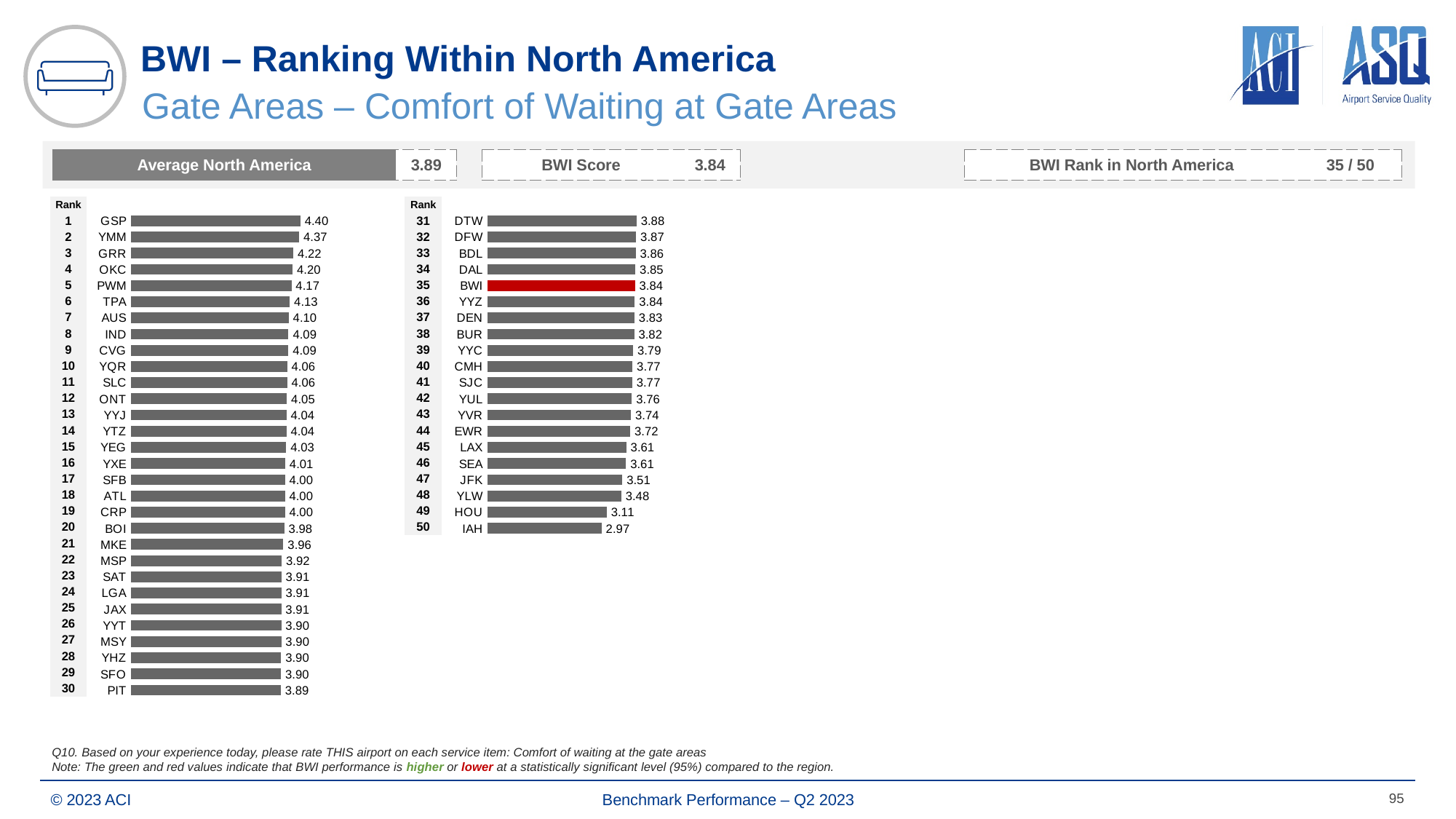
How many airports are plotted on the right chart (ranks 31–50)? 20 On the left chart (ranks 1–30), what is the value for PIT? 3.89 What kind of chart is used on the left to show the airport rankings? Bar chart On the left chart (ranks 1–30), what is the value for GSP? 4.40 On the right chart (ranks 31–50), which bar is highlighted in red? BWI On the left chart (ranks 1–30), which airport has the highest value? GSP On the left chart (ranks 1–30), which is larger, the value for YMM or the value for PWM? YMM How many airports are plotted on the left chart (ranks 1–30)? 30 On the right chart (ranks 31–50), what is the value for BWI? 3.84 On the right chart (ranks 31–50), what is the value for HOU? 3.11 On the right chart (ranks 31–50), what is the difference between the values for DTW and IAH? 0.91 On the right chart (ranks 31–50), which airport has the lowest value? IAH